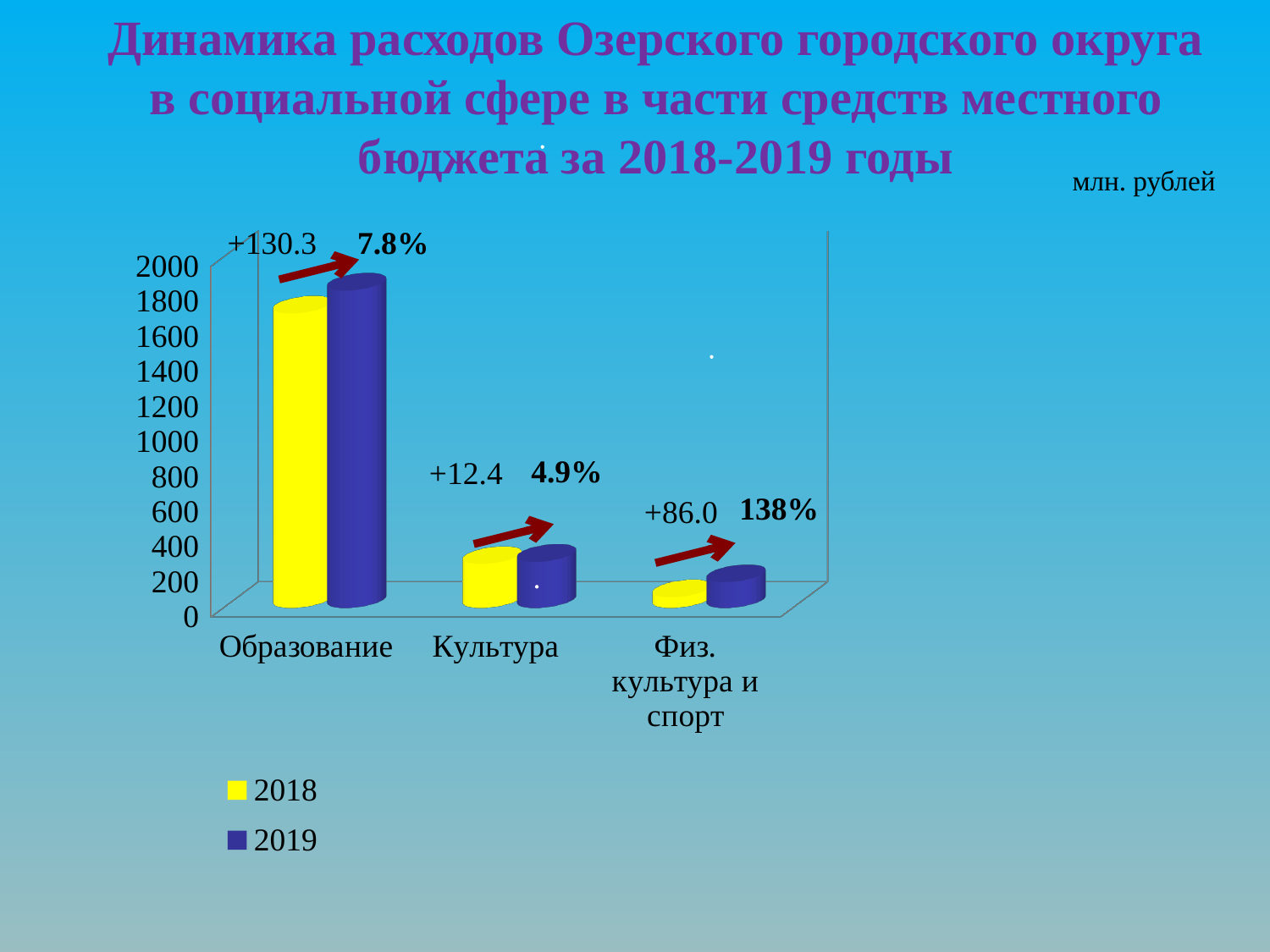
Which category has the highest spending in 2019? Образование In what units are the chart values expressed, according to the label at the top right? млн. рублей What kind of chart is shown on the slide? bar chart Is the 2019 value for Культура greater or less than 600? less Is the 2018 value for Образование greater or less than 1000? greater Is the 2018 value for Физ. культура и спорт greater or less than 200? less What percentage increase is annotated for Физ. культура и спорт? 138% For Образование, which year has the larger value, 2018 or 2019? 2019 How many categories are shown on the x axis of the chart? 3 Which category has the lowest spending in 2018? Физ. культура и спорт What absolute increase is annotated above the Образование bars? +130.3 How many series does the chart legend list? 2